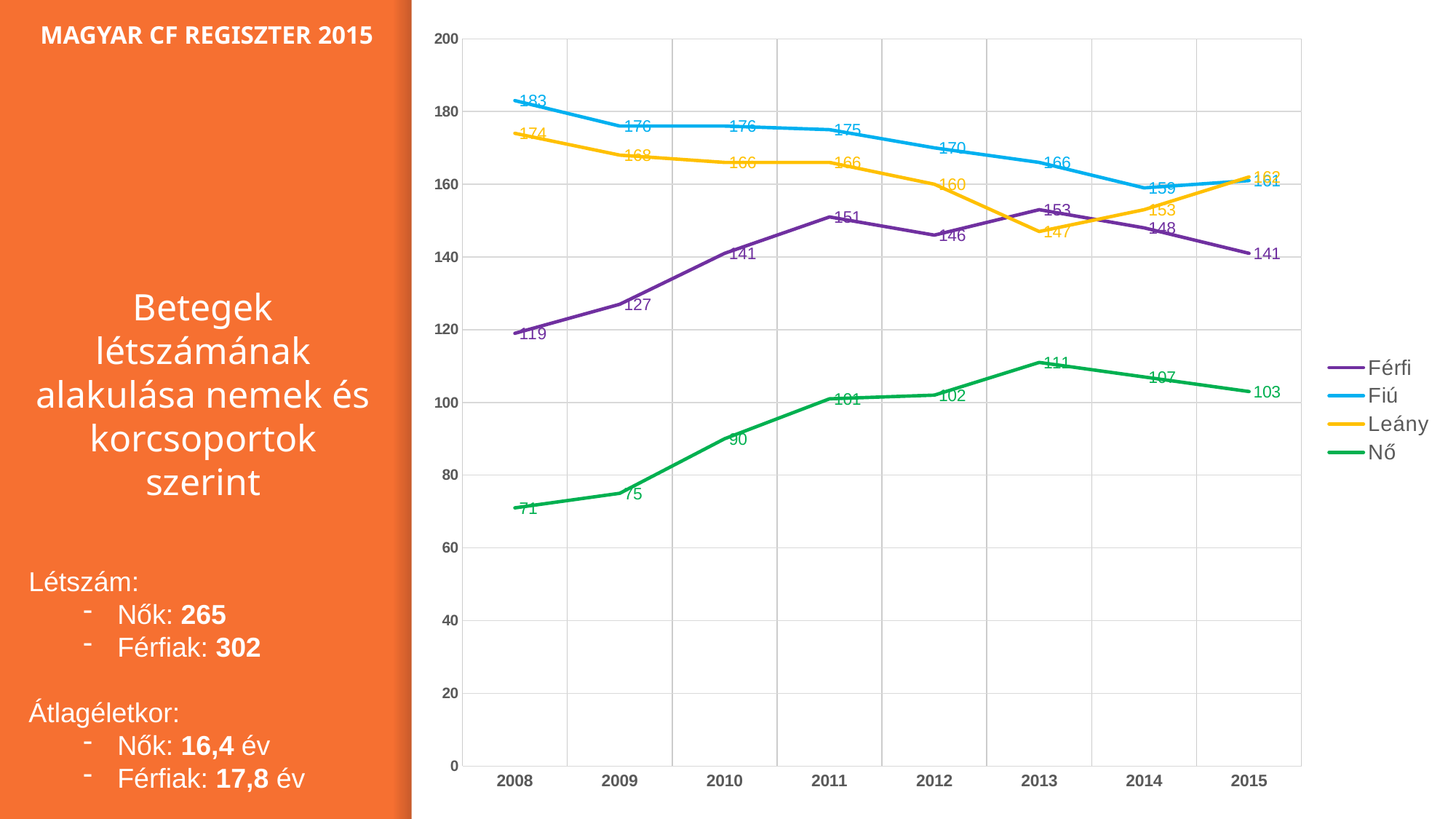
What is the value for Fiú in 2008? 183 In which year is the Nő series lowest? 2008 How many years are shown on the x axis? 8 What is the value for Férfi in 2011? 151 What is the value for Nő in 2013? 111 How many series does the legend list? 4 What is the difference between the Fiú value in 2008 and the Fiú value in 2015? 22 Which is larger in 2015, the Leány value or the Fiú value? Leány In which year is the Férfi series highest? 2013 What is the value for Leány in 2013? 147 What kind of chart is shown on the slide? line chart Does the Nő series generally rise or fall from 2008 to 2013? rise